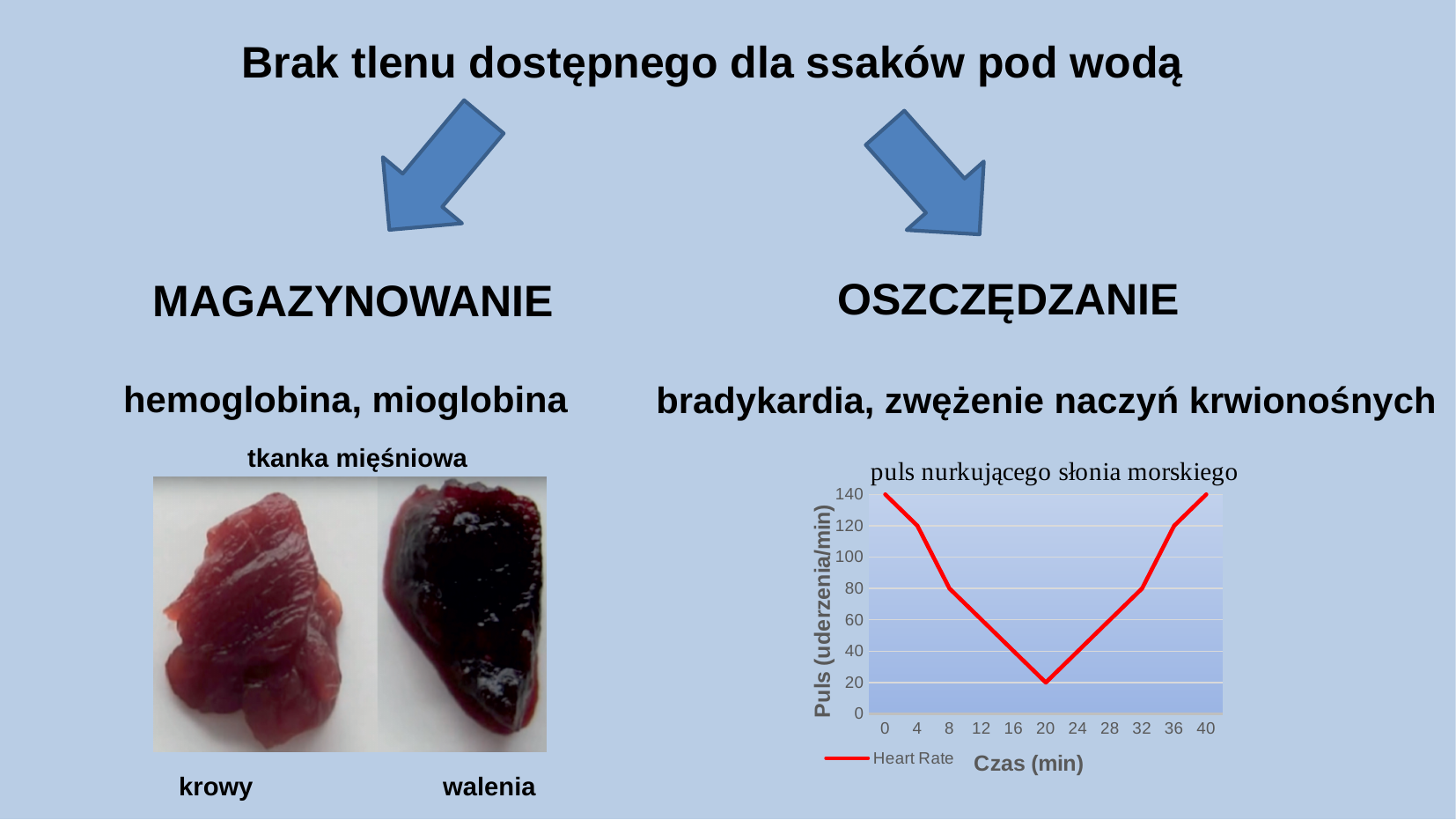
How many series does the chart legend list? 1 What is the label of the x axis of the chart? Czas (min) Does the heart rate rise or fall between 0 min and 20 min? fall What is the title of the chart? puls nurkującego słonia morskiego What is the heart rate value at 4 min? 120 What kind of chart is shown on the slide? line chart What is the heart rate value at 0 min? 140 Is the heart rate value at 12 min greater or less than 80? less Is the heart rate value at 28 min greater or less than 40? greater What is the heart rate value at 20 min? 20 What is the difference between the heart rate at 0 min and at 20 min? 120 At which time (in min) is the heart rate lowest? 20